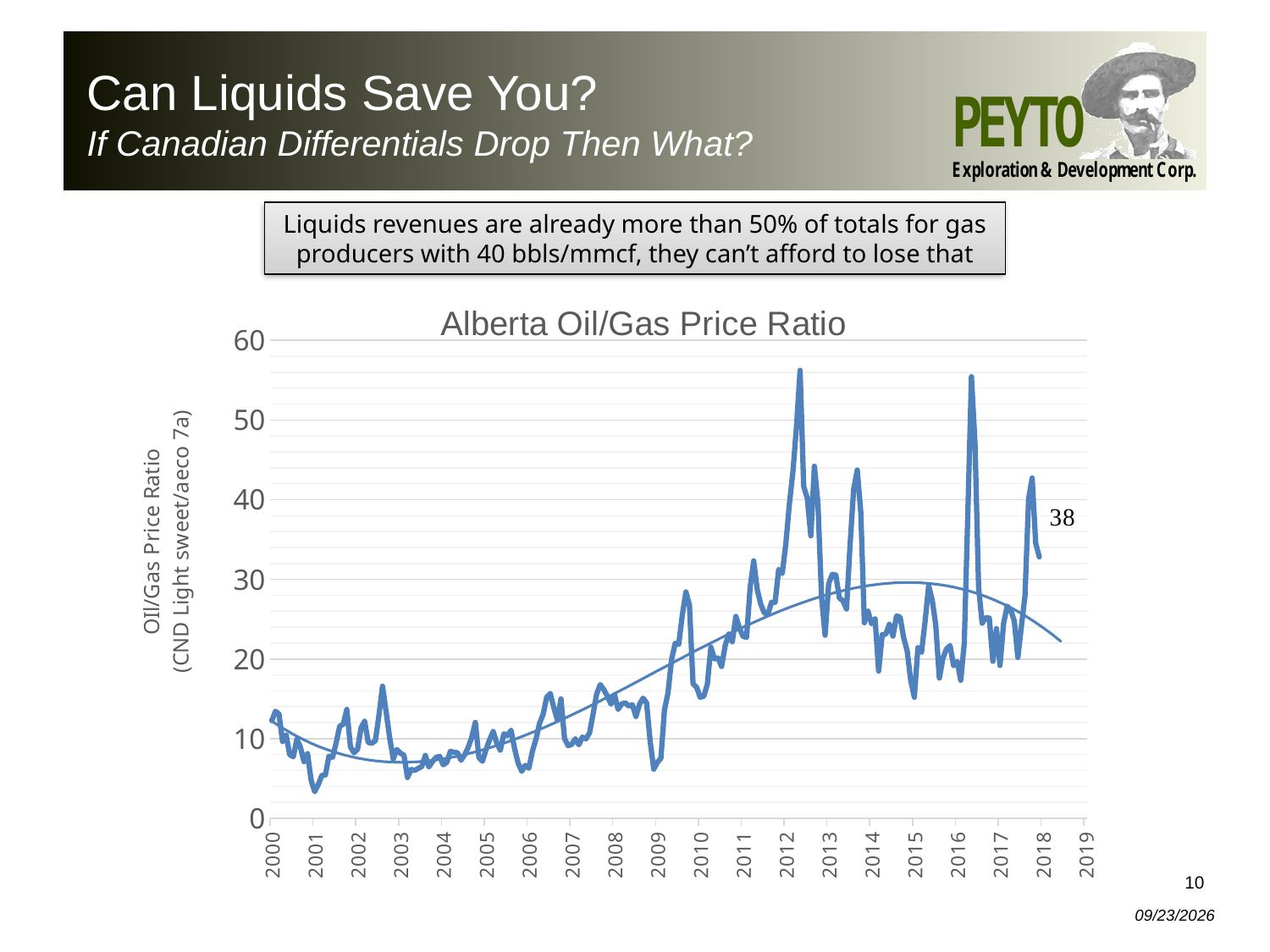
What is the label on the y axis? OIl/Gas Price Ratio (CND Light sweet/aeco 7a) Does the oil/gas price ratio generally rise or fall from 2000 to 2018? rise Are the values during 2003 greater or less than 10? less In which year does the series reach its lowest point? 2001 Is the value at the start of 2000 greater or less than 20? less Is the peak value reached in 2012 greater or less than 50? greater What kind of chart is shown on the slide? line chart What value is printed as a data label at the end of the series, near 2018? 38 What is the title of the chart? Alberta Oil/Gas Price Ratio Which year has the higher peak, 2012 or 2013? 2012